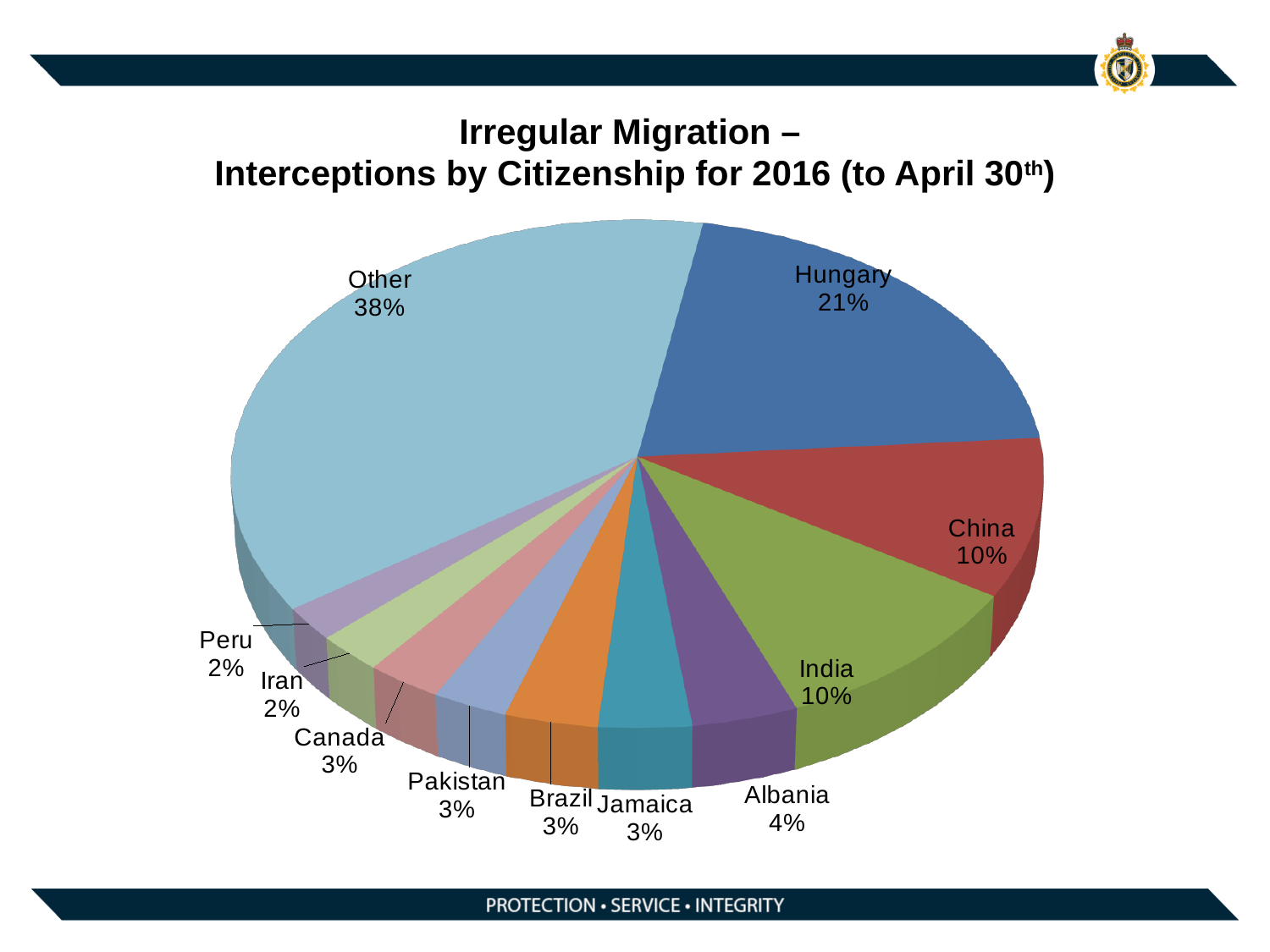
What is the title of the chart? Irregular Migration – Interceptions by Citizenship for 2016 (to April 30th) What is the combined share of China and India? 20% What percentage of the pie does the Other slice represent? 38% What is the difference in percentage points between the Other slice and the Hungary slice? 17 How many slices does the pie chart have? 11 Which citizenship category has the largest slice of the pie? Other What share of interceptions is attributed to Hungary? 21% Which is larger, the share for Hungary or the share for China? Hungary What share of interceptions is attributed to Peru? 2% What kind of chart is shown on the slide? Pie chart Which named country (excluding Other) has the largest share of interceptions? Hungary What share of interceptions is attributed to Albania? 4%